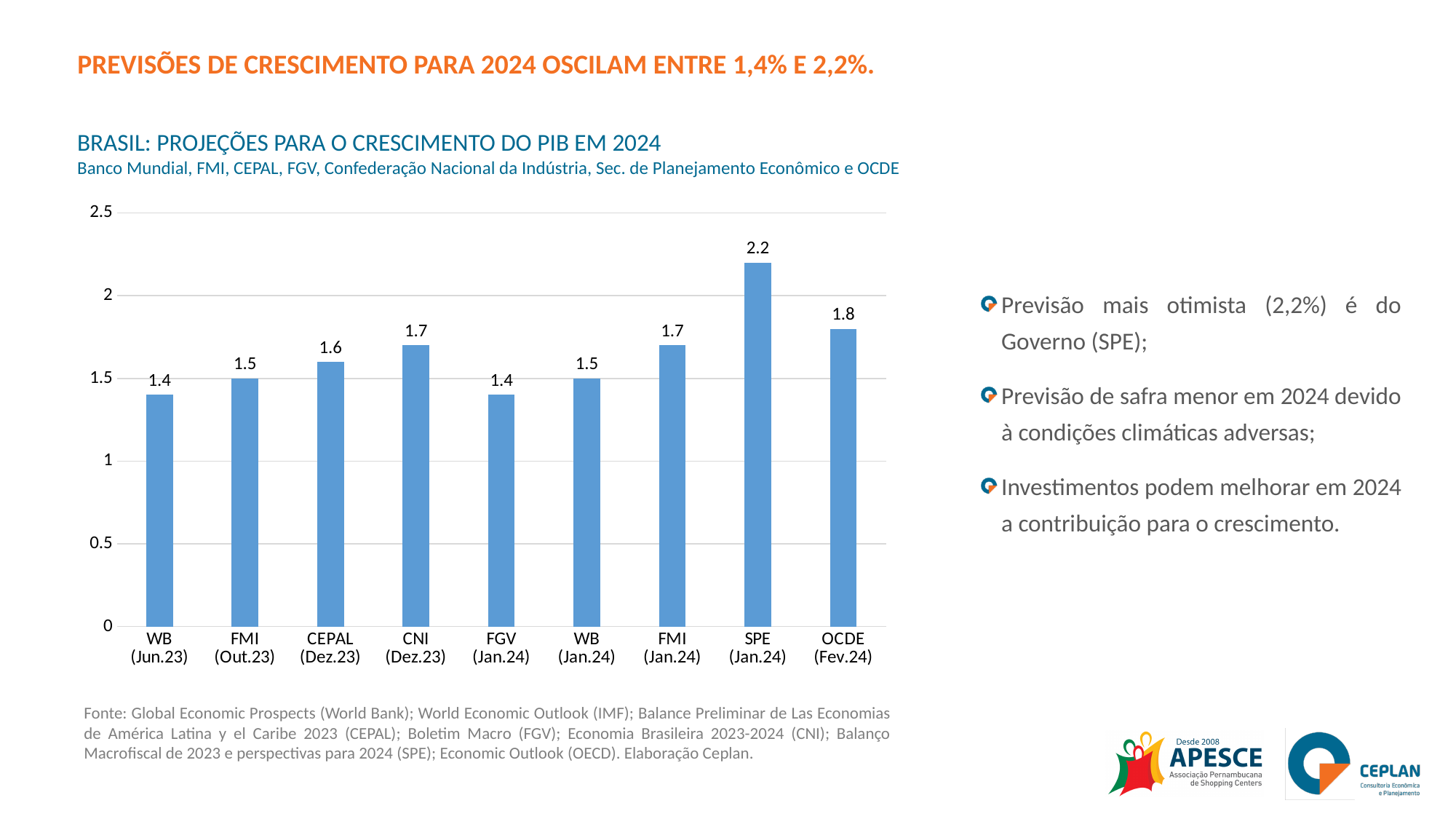
How many bars are shown in the chart? 9 What is the projected 2024 GDP growth value for SPE (Jan.24)? 2.2 What is the lowest value shown in the chart? 1.4 What is the difference between the SPE (Jan.24) value and the FGV (Jan.24) value? 0.8 What is the difference between the FMI (Jan.24) value and the FMI (Out.23) value? 0.2 What is the value shown for CEPAL (Dez.23)? 1.6 Which is larger, the value for CNI (Dez.23) or the value for FMI (Out.23)? CNI (Dez.23) What is the title of the chart? BRASIL: PROJEÇÕES PARA O CRESCIMENTO DO PIB EM 2024 Which category has the highest projected growth? SPE (Jan.24) What is the value shown for OCDE (Fev.24)? 1.8 What kind of chart is shown on the slide? Bar chart Is the value for OCDE (Fev.24) greater or less than 2? less